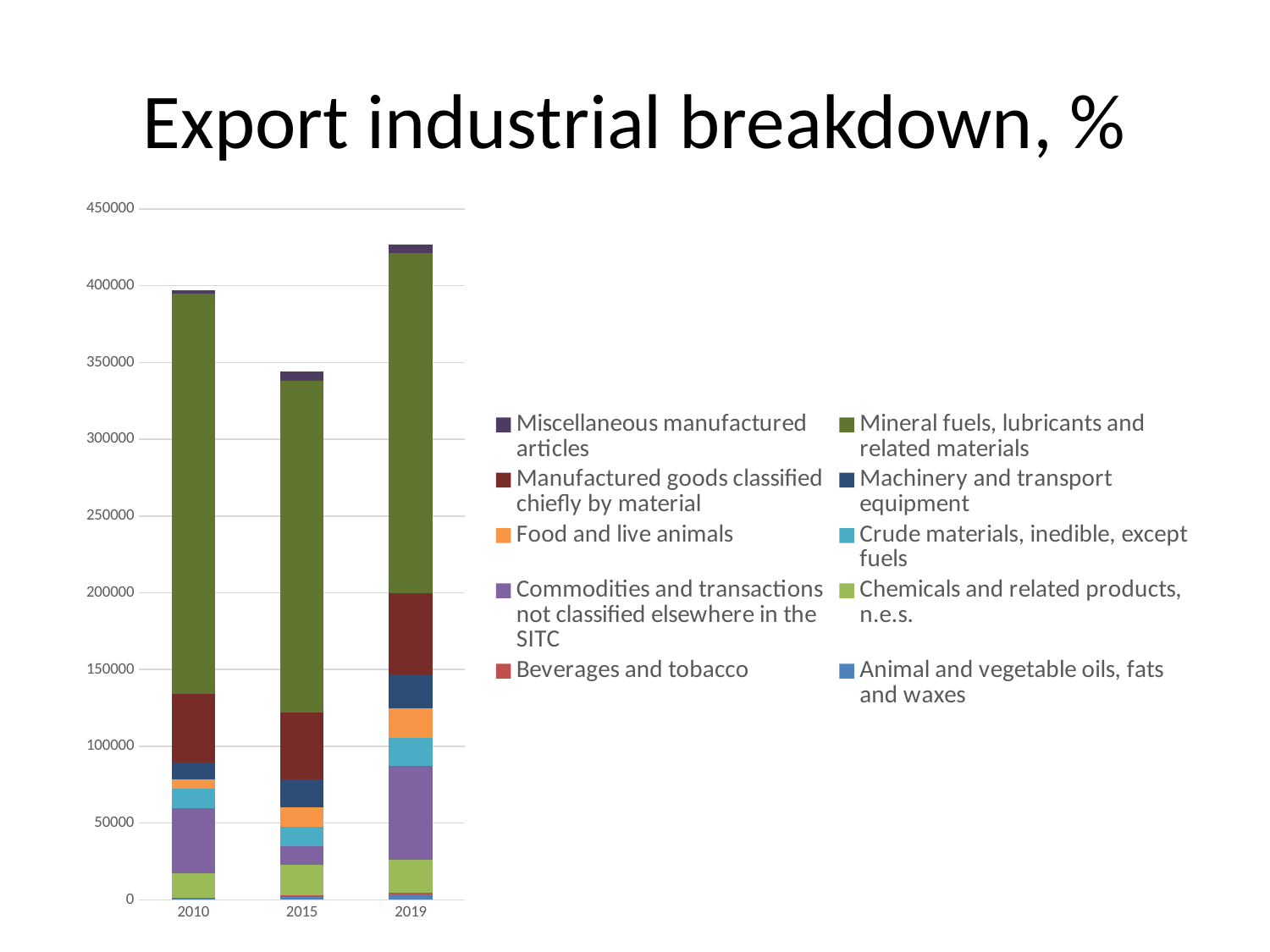
What kind of chart is shown on the slide? Stacked bar chart Which bar is taller, 2015 or 2019? 2019 Which year has the shortest stacked bar? 2015 How many series does the legend list? 10 Is the total of the 2010 bar greater or less than 350000? greater Is the total of the 2015 bar greater or less than 350000? less Do the bar totals rise steadily from 2010 to 2019? No, they fall in 2015 then rise in 2019 Which year has the tallest stacked bar? 2019 How many years (categories) are shown on the x axis? 3 Is the total of the 2019 bar greater or less than 400000? greater What is the title of the chart? Export industrial breakdown, % Which series takes up the largest portion of every bar? Mineral fuels, lubricants and related materials